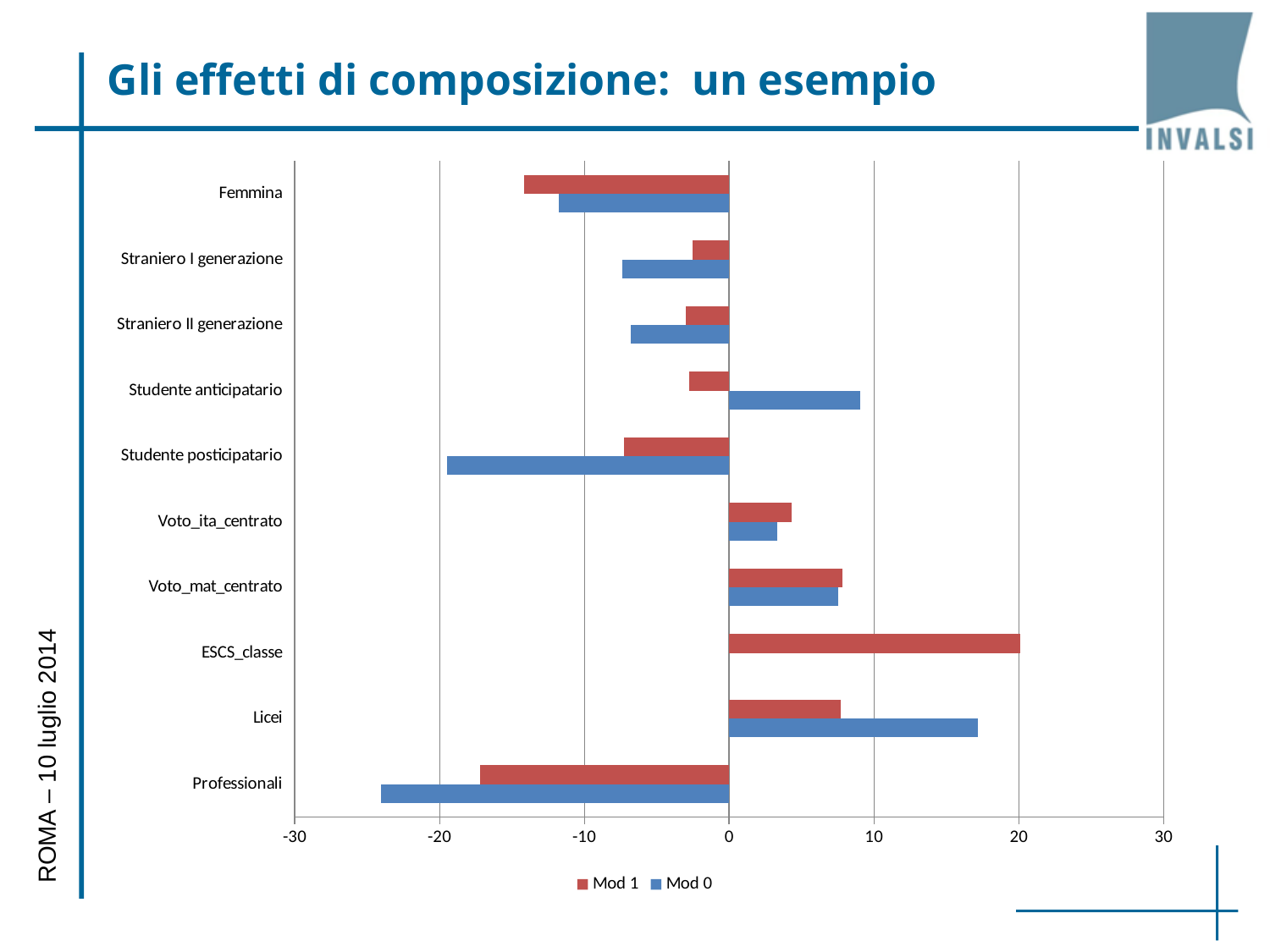
Which category has the lowest Mod 0 value? Professionali How many series does the legend list? 2 What is the title of the slide containing the chart? Gli effetti di composizione: un esempio How many categories are shown on the vertical axis of the chart? 10 Which category has the highest Mod 0 value? Licei Which category has the lowest Mod 1 value? Professionali Is the Mod 0 value for Studente posticipatario greater or less than -10? less Is the Mod 1 value for ESCS_classe greater or less than 10? greater For Licei, which series has the larger value, Mod 1 or Mod 0? Mod 0 Which category has the highest Mod 1 value? ESCS_classe Is the Mod 0 value for Professionali greater or less than -20? less What kind of chart is shown on the slide? bar chart